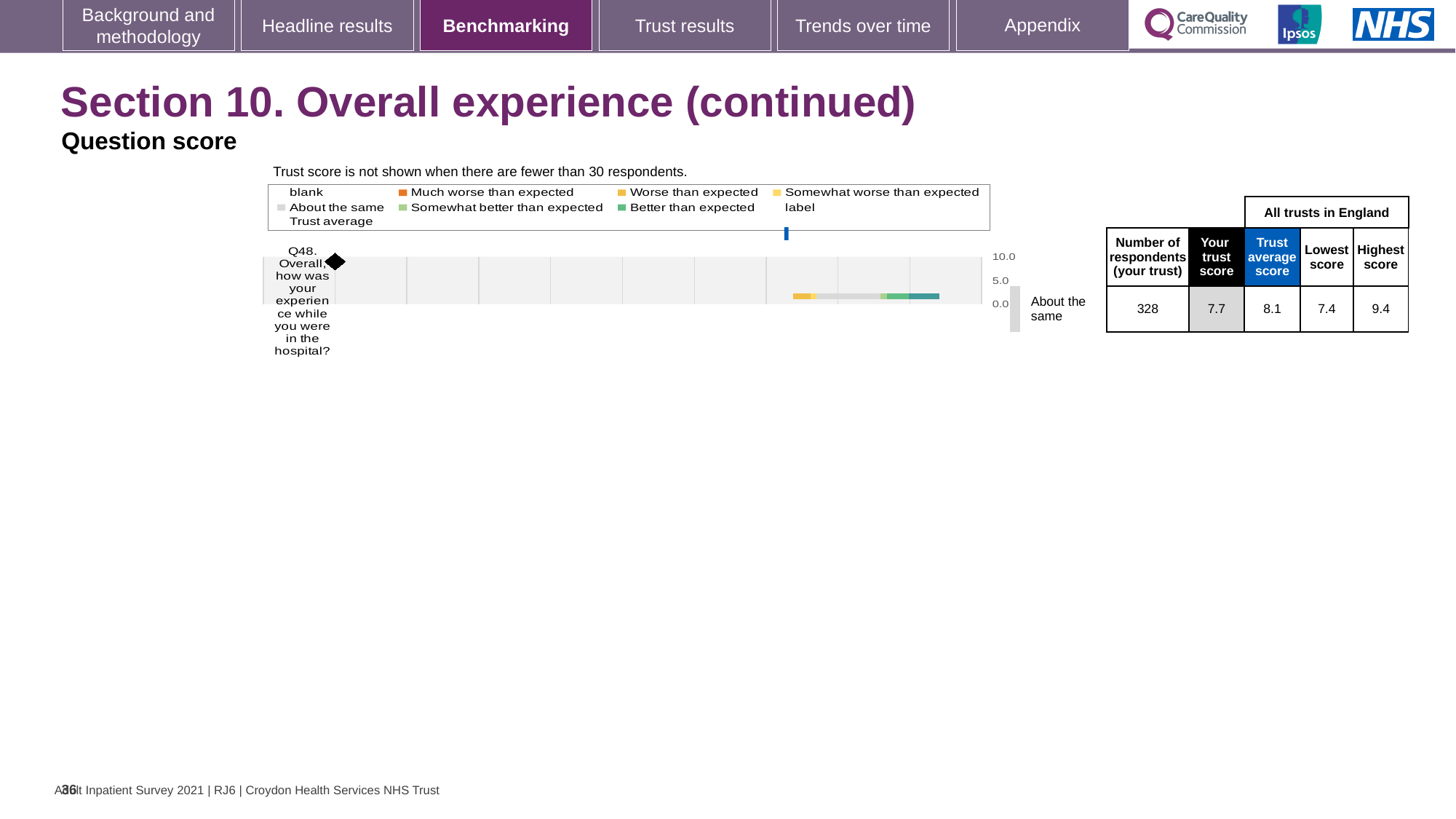
What is the difference between the trust average score and the trust's own score for Q48? 0.4 Which is larger for Q48, the trust's own score or the trust average score? Trust average score How many survey questions are plotted on the chart? 1 What is the lowest score among all trusts in England for Q48? 7.4 How many respondents from the trust answered Q48? 328 What kind of chart is used to show the Q48 benchmarking result? Bar chart What is the highest score among all trusts in England for Q48? 9.4 What benchmark category is the trust's Q48 score placed in? About the same What is the trust average score for Q48? 8.1 What is the difference between the highest score and the lowest score for Q48? 2.0 What is the trust score for Q48 (Overall, how was your experience while you were in the hospital?)? 7.7 What is the maximum value shown on the chart's score axis? 10.0